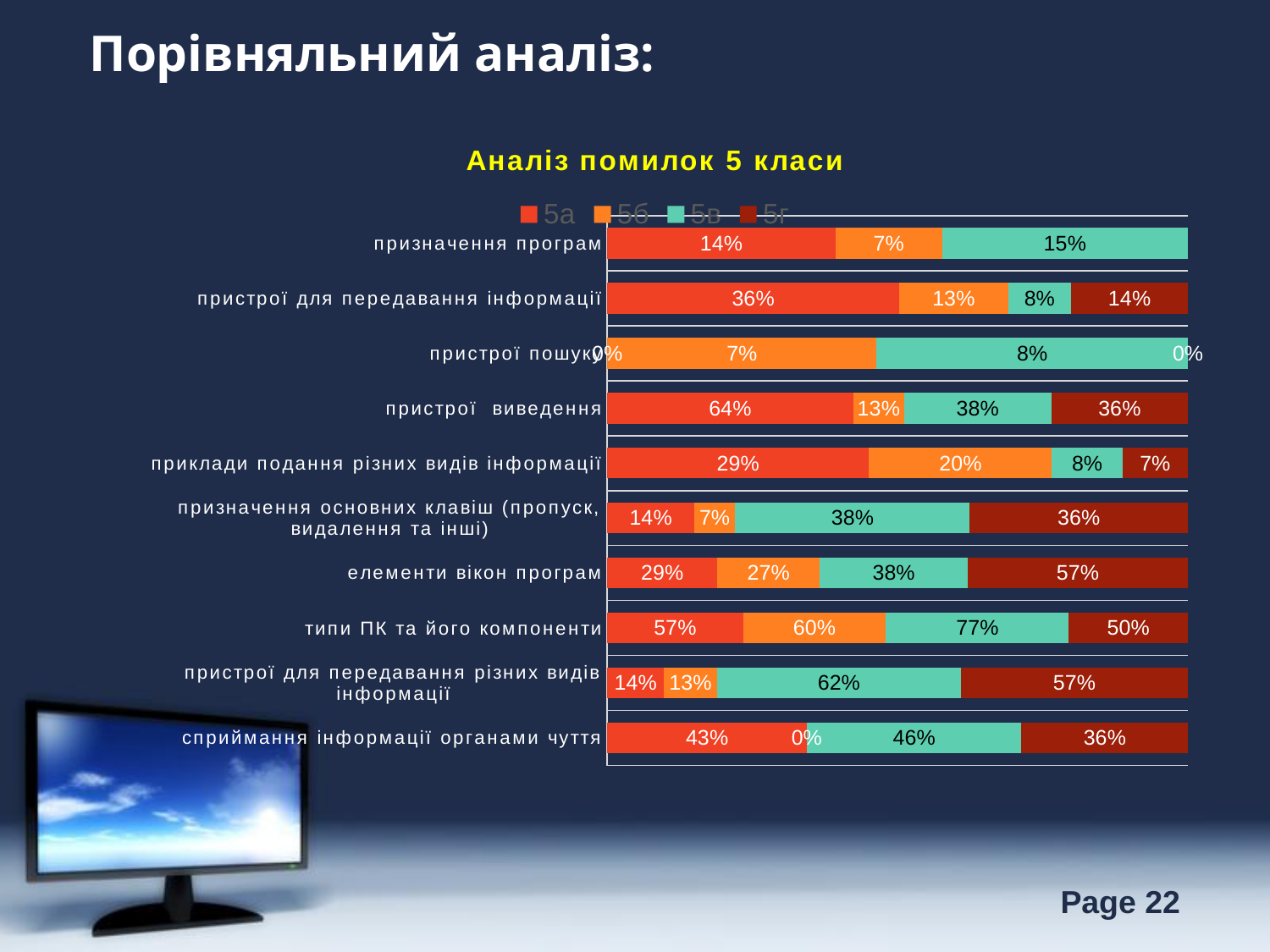
What is the value for 5в in the category 'типи ПК та його компоненти'? 77% What is the value for 5б in the category 'сприймання інформації органами чуття'? 0% What is the difference between the 5в and 5а values in the category 'пристрої для передавання різних видів інформації'? 48% What is the value for 5а in the category 'пристрої виведення'? 64% What is the title of the chart? Аналіз помилок 5 класи How many categories are shown on the chart? 10 In the category 'елементи вікон програм', which is larger: the value for 5а or the value for 5б? 5а Which category has the highest value for the 5в series? типи ПК та його компоненти Which category has the highest value for the 5а series? пристрої виведення What is the value for 5г in the category 'елементи вікон програм'? 57% How many series does the legend list? 4 What type of chart is shown on the slide? stacked bar chart